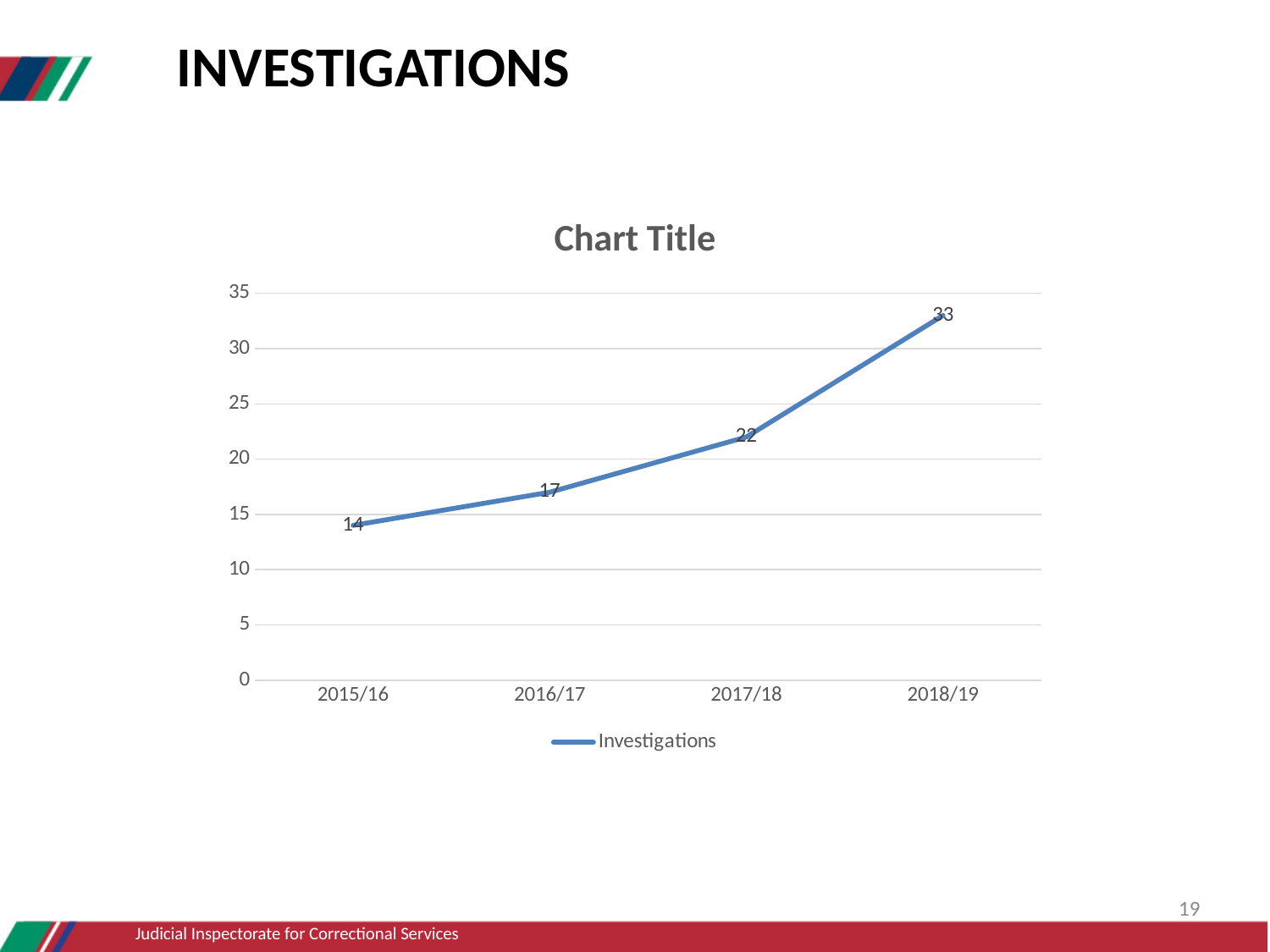
How many series does the legend list? 1 Which year has the lowest number of Investigations? 2015/16 How many years are shown on the x axis? 4 Which year has more Investigations, 2016/17 or 2017/18? 2017/18 What is the value for Investigations in 2017/18? 22 Do the Investigations values rise or fall from 2015/16 to 2018/19? Rise What is the value for Investigations in 2016/17? 17 What is the difference in Investigations between 2018/19 and 2017/18? 11 What is the value for Investigations in 2018/19? 33 What kind of chart is shown on the slide? Line chart What is the value for Investigations in 2015/16? 14 Which year has the highest number of Investigations? 2018/19